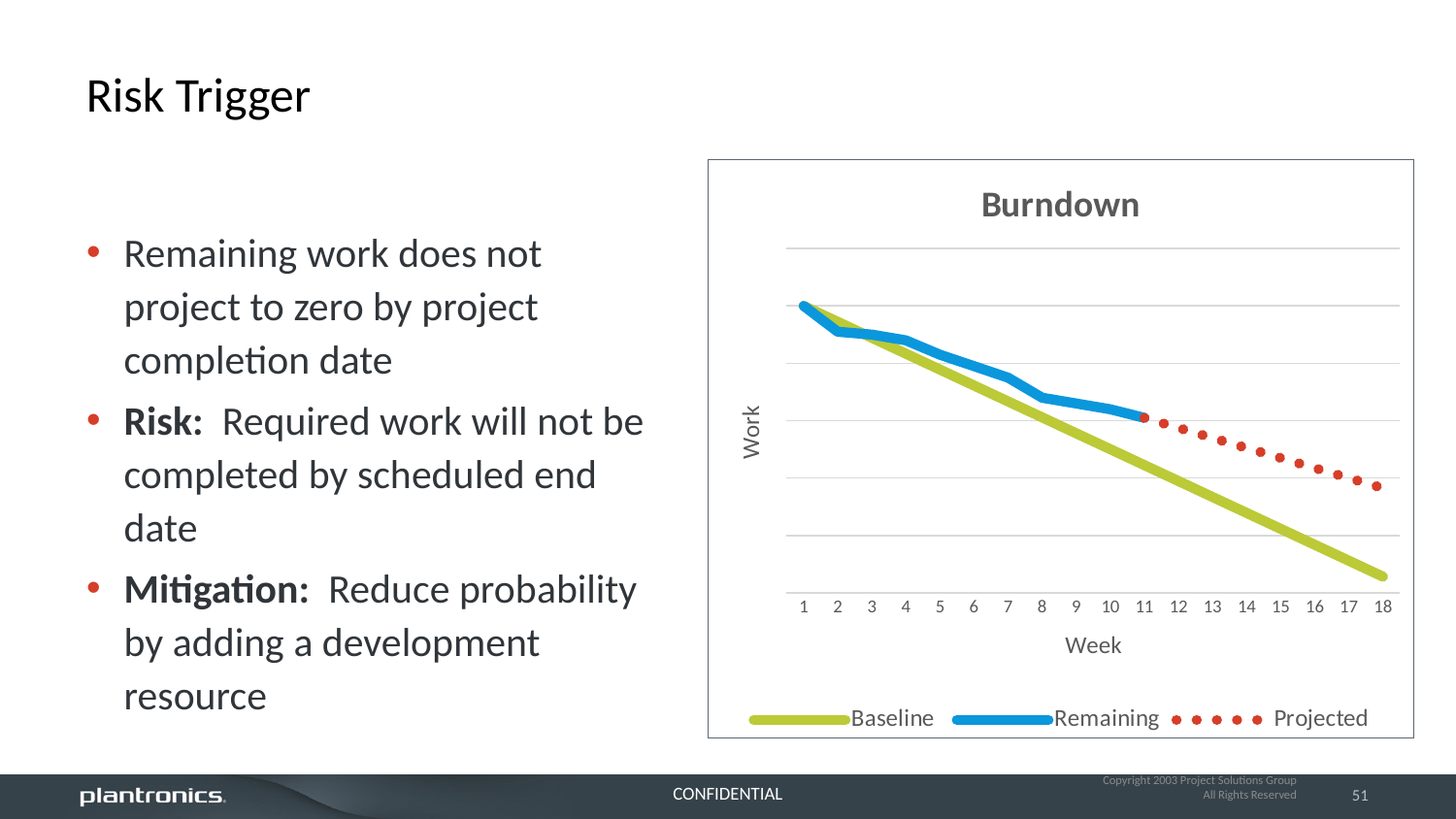
Does the Baseline series rise or fall as the week number increases? Fall What is the label of the y axis? Work At week 8, which series has the higher value, Remaining or Baseline? Remaining What are the names of the series listed in the legend? Baseline, Remaining, Projected How many series does the chart's legend list? 3 At which week does the Remaining series end and the Projected series begin? Week 11 Does the Remaining series rise or fall from week 1 to week 11? Fall At week 18, which series has the higher value, Baseline or Projected? Projected How many weeks are shown on the x axis of the chart? 18 What kind of chart is shown on the slide? Line chart